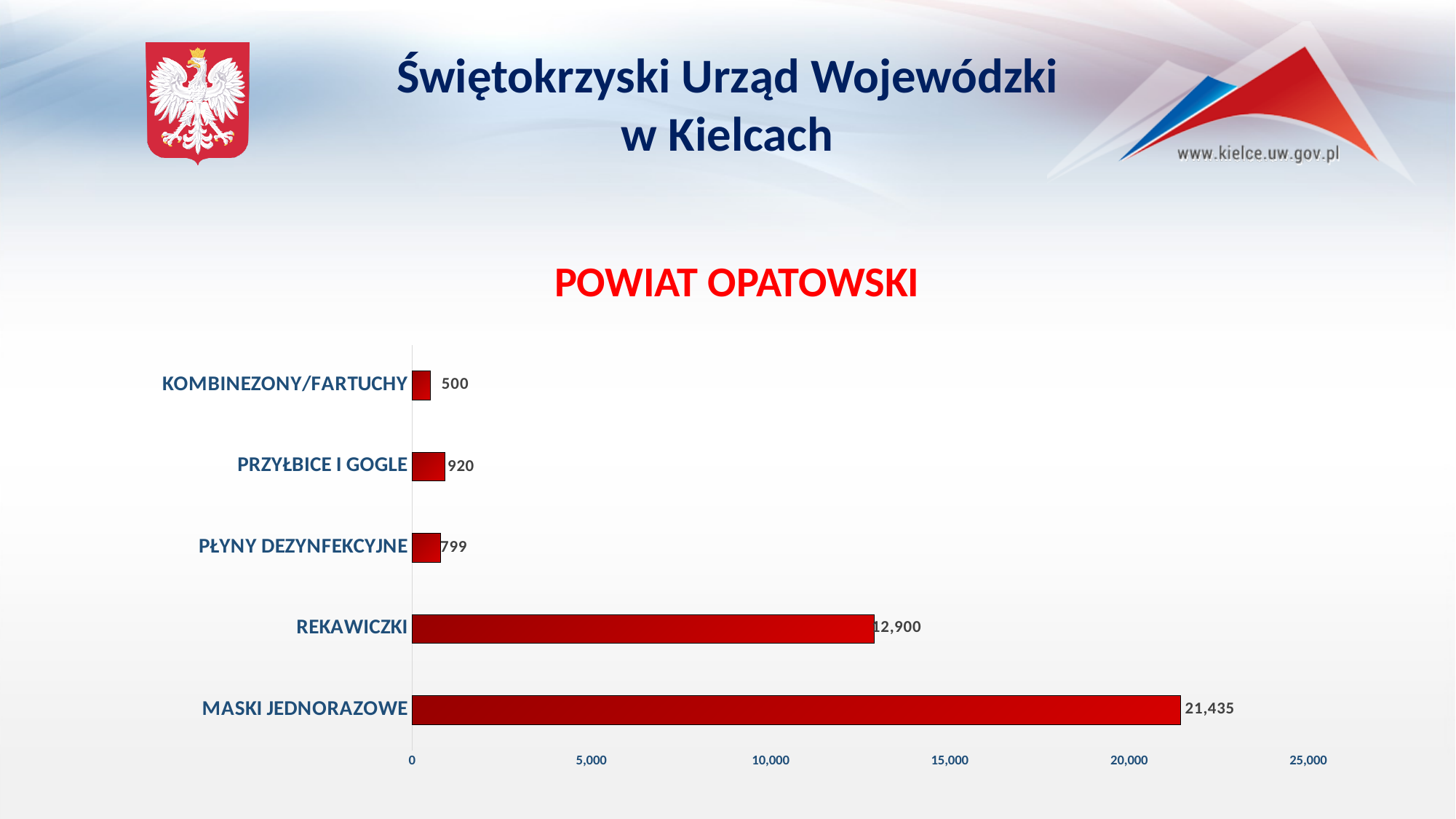
How many categories are shown in the chart? 5 What is the value for KOMBINEZONY/FARTUCHY? 500 What is the value for PRZYŁBICE I GOGLE? 920 Which is larger, the value for PRZYŁBICE I GOGLE or the value for PŁYNY DEZYNFEKCYJNE? PRZYŁBICE I GOGLE What kind of chart is shown on the slide? bar chart Is the value for REKAWICZKI greater or less than 10,000? greater What is the difference between the values for MASKI JEDNORAZOWE and REKAWICZKI? 8,535 What is the value for MASKI JEDNORAZOWE? 21,435 What is the value for PŁYNY DEZYNFEKCYJNE? 799 Which category has the lowest value? KOMBINEZONY/FARTUCHY Which category has the highest value? MASKI JEDNORAZOWE What is the value for REKAWICZKI? 12,900